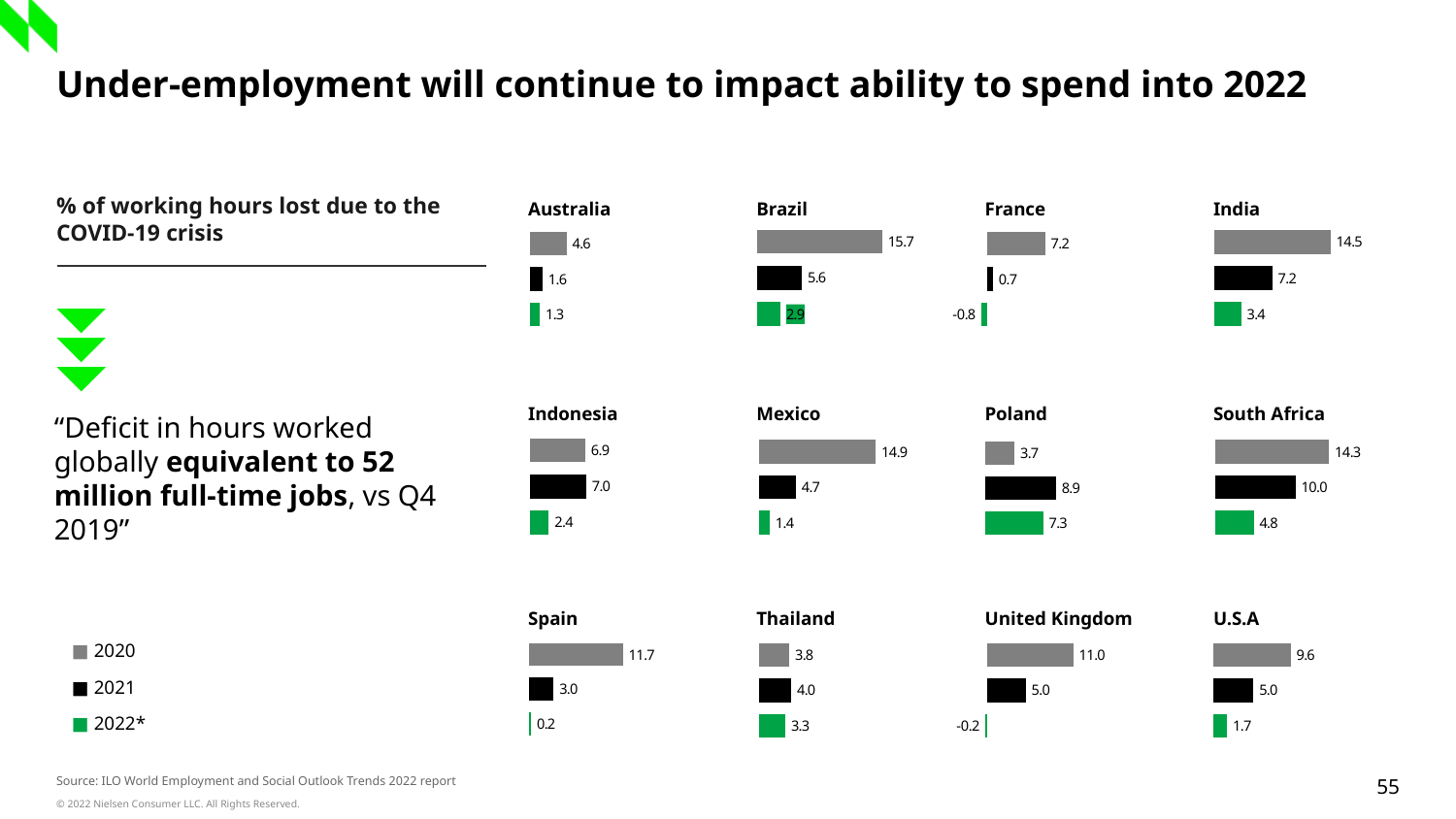
How many series does the legend list? 3 In the Mexico chart, which is larger, the 2021 value or the 2022* value? 2021 In the Poland chart, which year has the lowest value? 2020 In the Brazil chart, what is the value for 2020? 15.7 In the Spain chart, what is the value for 2022*? 0.2 In the India chart, what is the difference between the 2020 value and the 2021 value? 7.3 In the Poland chart, what is the value for 2021? 8.9 What kind of chart is used for each country on the slide? Bar chart How many bars are shown in the United Kingdom chart? 3 In the France chart, what is the value for 2022*? -0.8 In the South Africa chart, which year has the highest value? 2020 In the U.S.A chart, do the values rise or fall from 2020 to 2022*? Fall